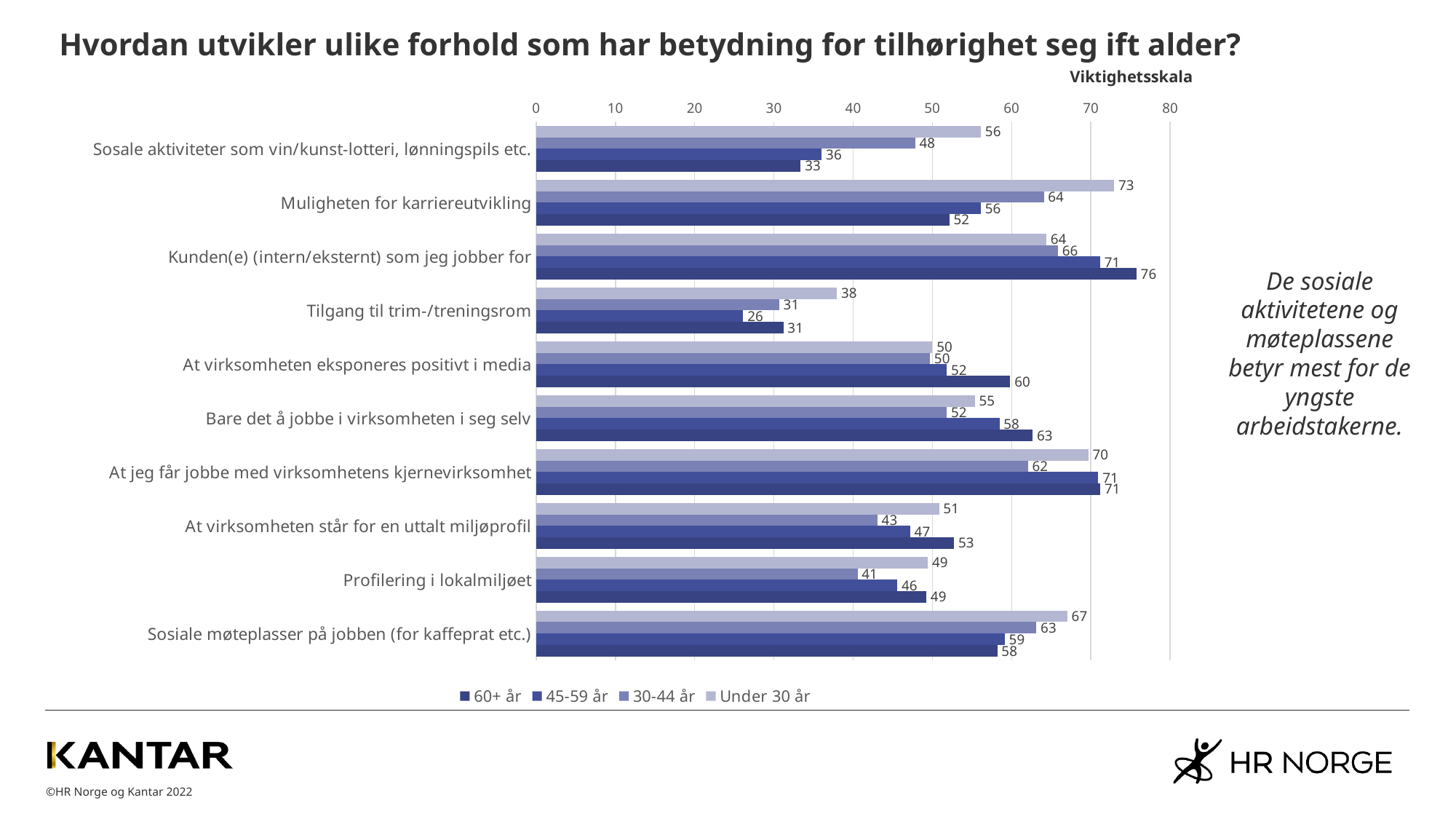
Which category has the highest value for '60+ år'? Kunden(e) (intern/eksternt) som jeg jobber for What is the value for '30-44 år' for 'Sosiale møteplasser på jobben (for kaffeprat etc.)'? 63 What is the value for 'Under 30 år' for 'Muligheten for karriereutvikling'? 73 What kind of chart is shown on the slide? Bar chart For 'At virksomheten eksponeres positivt i media', which is larger: the value for '60+ år' or for 'Under 30 år'? 60+ år What is the value for '45-59 år' for 'Tilgang til trim-/treningsrom'? 26 What is the difference between the 'Under 30 år' and '60+ år' values for 'Sosiale aktiviteter som vin/kunst-lotteri, lønningspils etc.'? 23 How many series does the legend list? 4 How many categories are plotted on the chart? 10 Which category has the lowest value for 'Under 30 år'? Tilgang til trim-/treningsrom What is the label of the x axis scale shown above the chart? Viktighetsskala What is the value for '60+ år' for 'Kunden(e) (intern/eksternt) som jeg jobber for'? 76